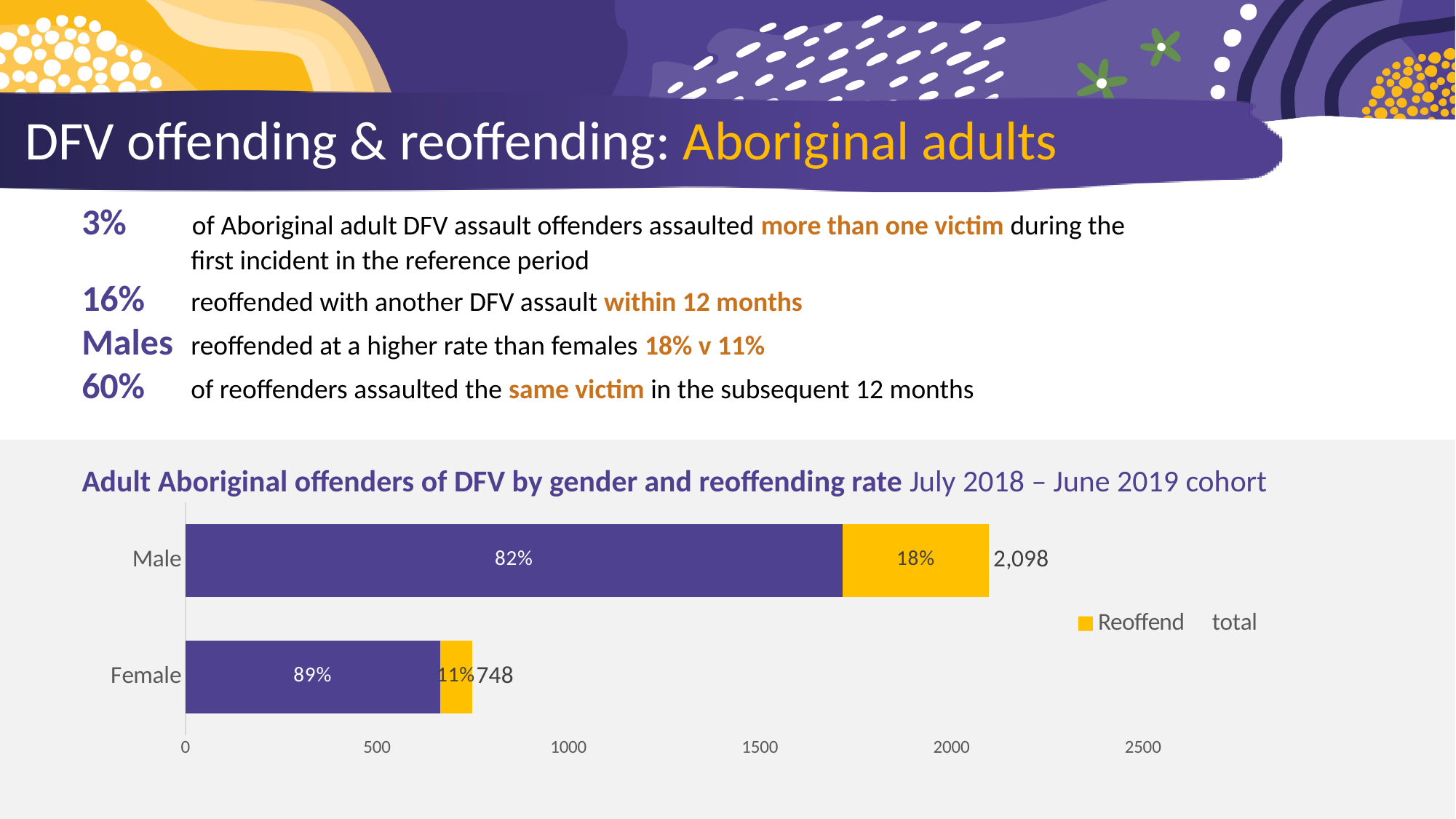
What percentage is shown in the purple segment of the Female bar? 89% What is the difference between the Male total and the Female total? 1,350 How many categories are shown on the chart? 2 What is the title of the chart? Adult Aboriginal offenders of DFV by gender and reoffending rate July 2018 – June 2019 cohort What type of chart is shown on the slide? bar chart Which category has the larger total, Male or Female? Male What percentage is shown in the Reoffend segment of the Female bar? 11% What total is labelled at the end of the Male bar? 2,098 Is the total for Female greater or less than 1000? less How many series does the chart legend list? 2 What percentage is shown in the Reoffend segment of the Male bar? 18% What total is labelled at the end of the Female bar? 748